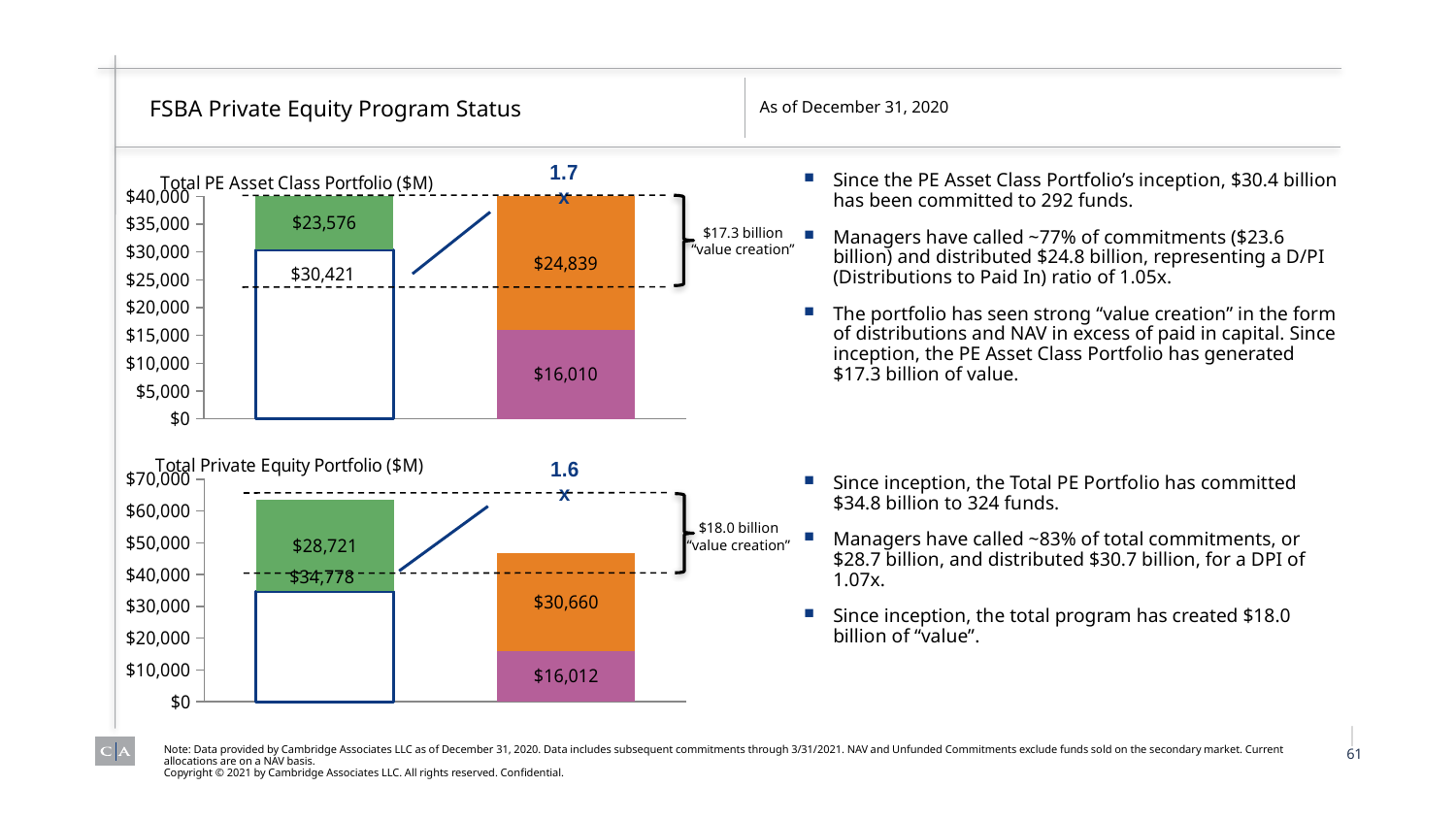
In the Total Private Equity Portfolio ($M) chart, what is the total of the right-hand stacked bar (orange plus purple segments)? $46,672 In the Total PE Asset Class Portfolio ($M) chart, what is the difference between the orange segment ($24,839) and the purple segment ($16,010) of the right-hand bar? $8,829 In the Total Private Equity Portfolio ($M) chart, what value is labelled on the white outlined segment of the left-hand bar? $34,778 In the Total Private Equity Portfolio ($M) chart, what value is labelled on the orange segment of the right-hand bar? $30,660 In the Total Private Equity Portfolio ($M) chart, what is the difference between the white segment ($34,778) and the green segment ($28,721) of the left-hand bar? $6,057 In the Total PE Asset Class Portfolio ($M) chart, what value is labelled on the orange segment of the right-hand bar? $24,839 What kind of chart is the Total PE Asset Class Portfolio ($M) chart? Stacked bar chart In the Total Private Equity Portfolio ($M) chart, which segment of the right-hand bar is larger, the orange one or the purple one? The orange one In the Total PE Asset Class Portfolio ($M) chart, what is the total of the right-hand stacked bar (orange plus purple segments)? $40,849 In the Total PE Asset Class Portfolio ($M) chart, what value is labelled on the purple segment of the right-hand bar? $16,010 In the Total PE Asset Class Portfolio ($M) chart, what value is labelled on the green segment of the left-hand bar? $23,576 What multiple is printed above the right-hand bar of the Total Private Equity Portfolio ($M) chart? 1.6